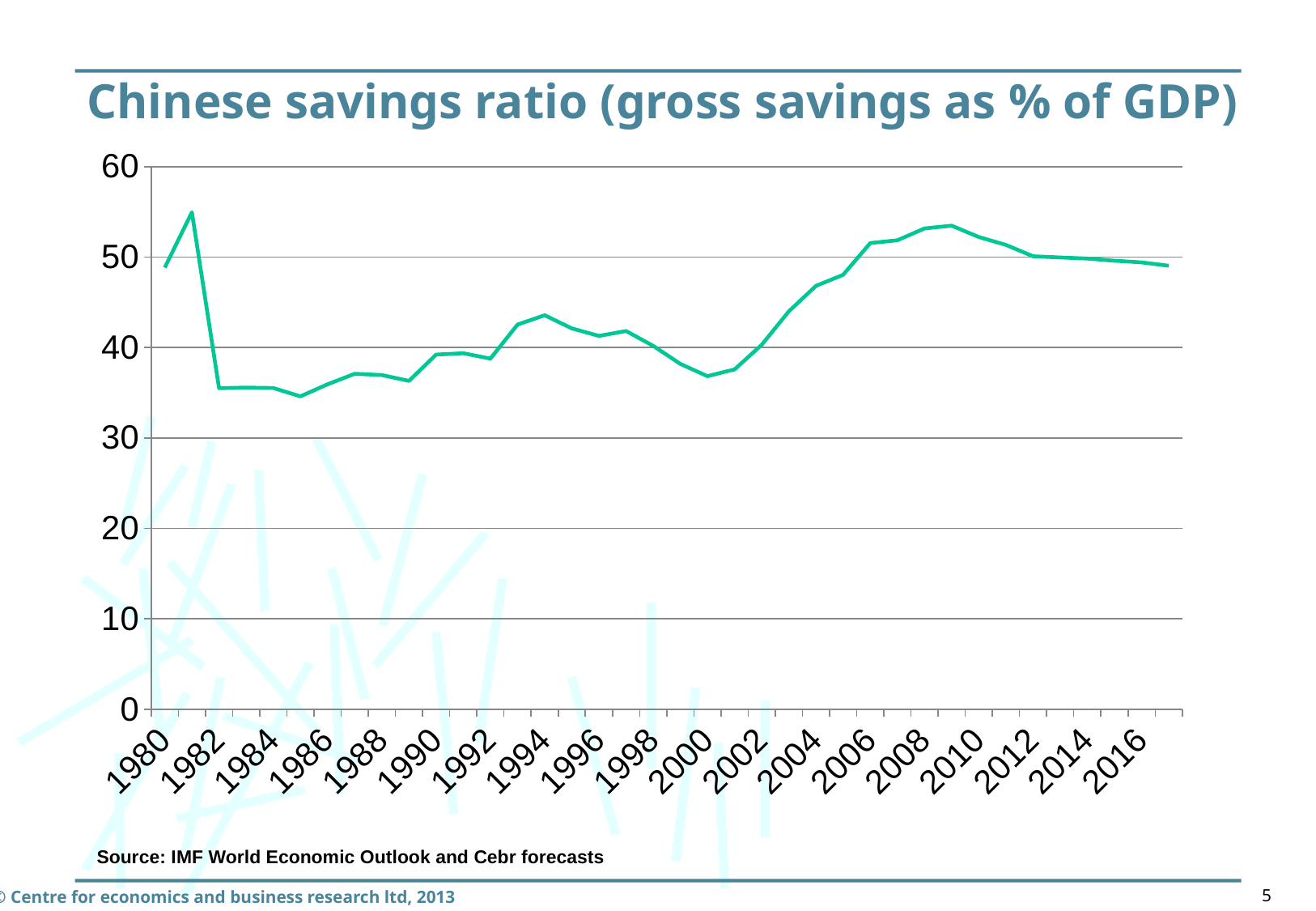
How many year labels are shown on the x axis? 19 Which is larger, the value for 2008 or the value for 2000? 2008 Which is larger, the value for 1980 or the value for 1982? 1980 Is the value for 2008 greater or less than 50? greater Does the savings ratio rise or fall between 2000 and 2008? rise What kind of chart is shown on the slide? line chart Is the value for 1986 greater or less than 40? less Is the value for 1982 greater or less than 40? less What source is cited below the chart? IMF World Economic Outlook and Cebr forecasts What is the title of the chart? Chinese savings ratio (gross savings as % of GDP)